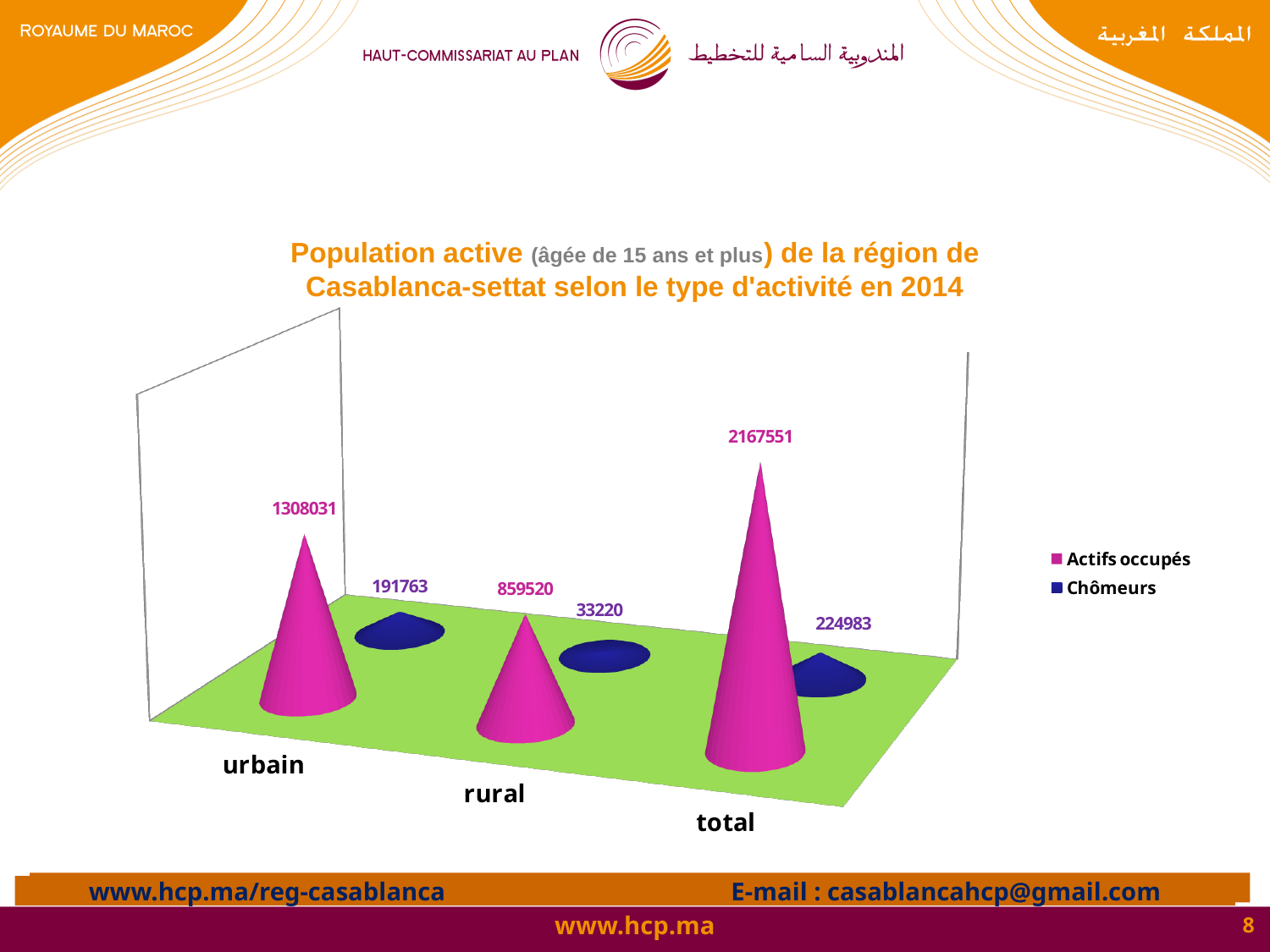
How many categories are shown on the x axis? 3 Which category has the highest value for Actifs occupés? total What is the value for Actifs occupés in the urbain category? 1308031 What is the value for Chômeurs in the rural category? 33220 Which category has the lowest value for Chômeurs? rural Which is larger: Chômeurs in urbain or Chômeurs in total? Chômeurs in total What is the difference between Actifs occupés in urbain and Actifs occupés in rural? 448511 What is the value for Chômeurs in the urbain category? 191763 Which series is shown in blue in the legend? Chômeurs What kind of chart is shown on the slide? bar chart What is the value for Actifs occupés in the total category? 2167551 How many series does the legend list? 2